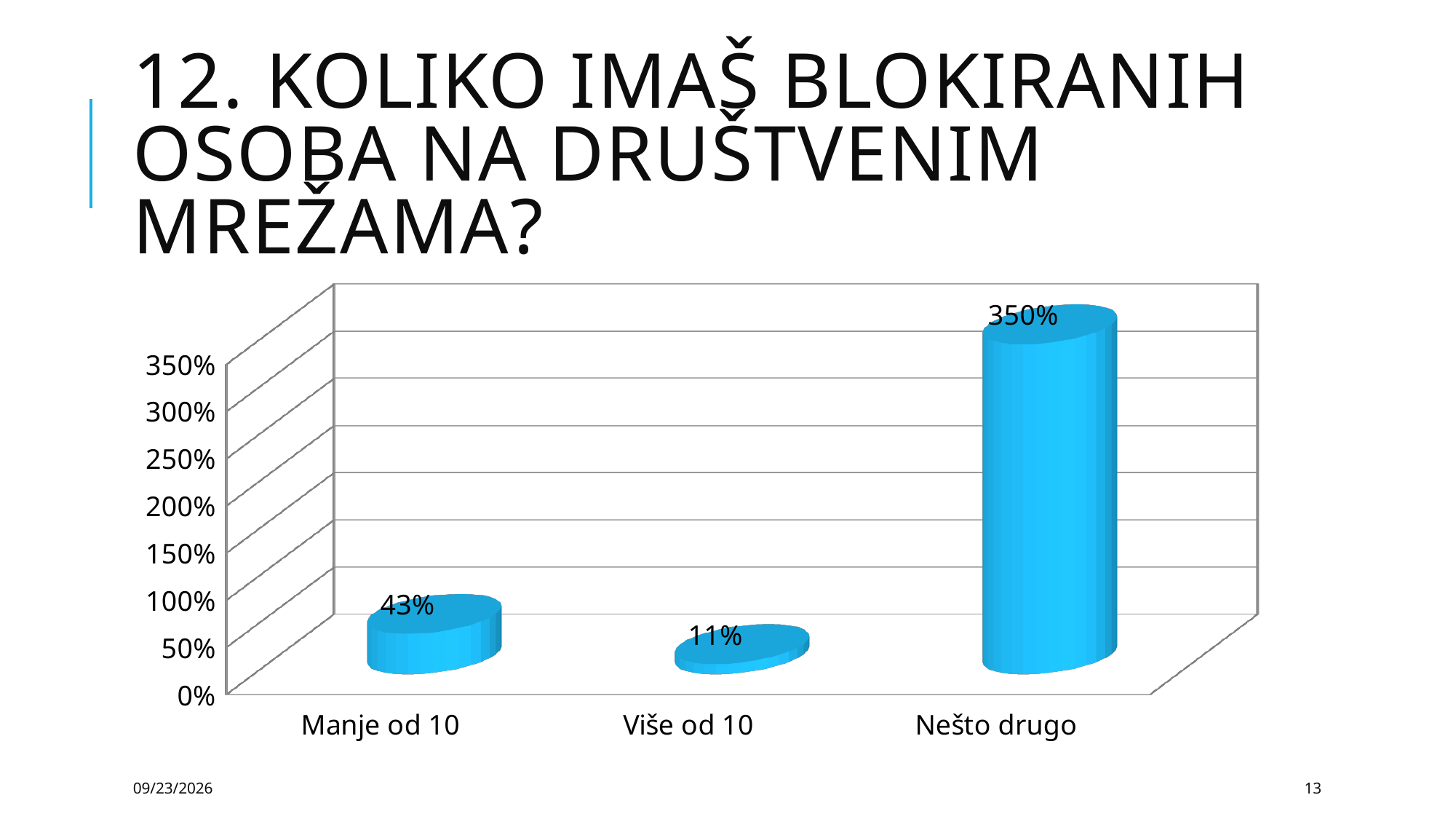
Which is larger, the value for "Manje od 10" or the value for "Više od 10"? Manje od 10 Which category has the highest value? Nešto drugo How many categories are shown on the x axis? 3 What is the difference between the values for "Manje od 10" and "Više od 10"? 32% Which category has the lowest value? Više od 10 What kind of chart is shown on the slide? bar chart What is the value for "Manje od 10"? 43% What is the value for "Nešto drugo"? 350% What is the value for "Više od 10"? 11% What is the highest tick label shown on the vertical axis? 350% Is the value for "Nešto drugo" greater or less than 300%? greater What is the difference between the values for "Nešto drugo" and "Manje od 10"? 307%